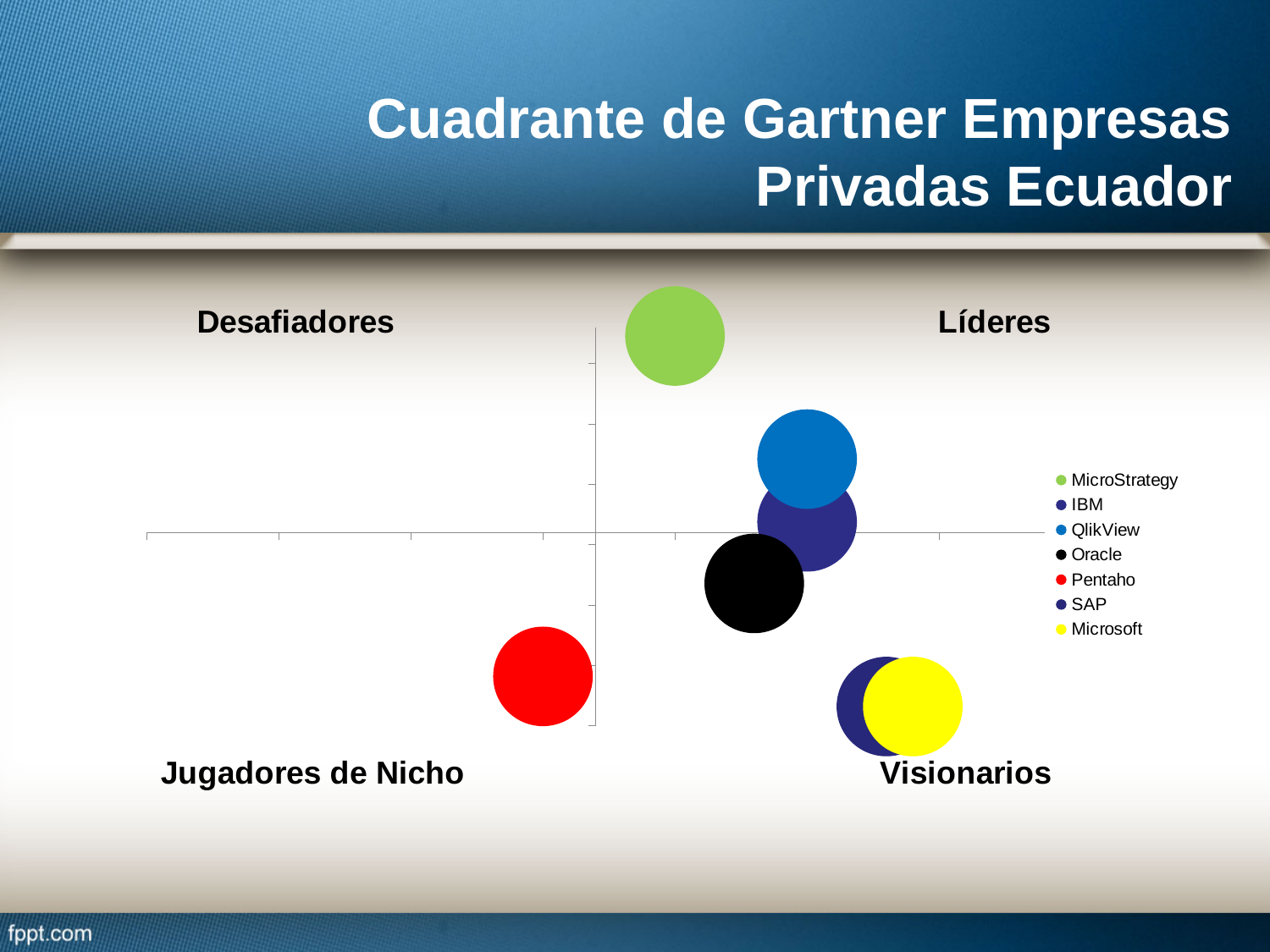
What kind of chart is shown on the slide? bubble chart What colour is the MicroStrategy bubble? green Which bubble is positioned higher on the chart, MicroStrategy or Oracle? MicroStrategy In which quadrant does the Microsoft bubble appear? Visionarios How many bubbles are plotted on the chart? 7 In which quadrant does the Pentaho bubble appear? Jugadores de Nicho Which company's bubble is positioned furthest to the right on the chart? Microsoft What is the title of the slide containing the chart? Cuadrante de Gartner Empresas Privadas Ecuador How many series does the legend list? 7 Which company's bubble is positioned furthest to the left on the chart? Pentaho Which company's bubble is positioned highest on the chart? MicroStrategy Which bubble is positioned further to the right, Pentaho or QlikView? QlikView